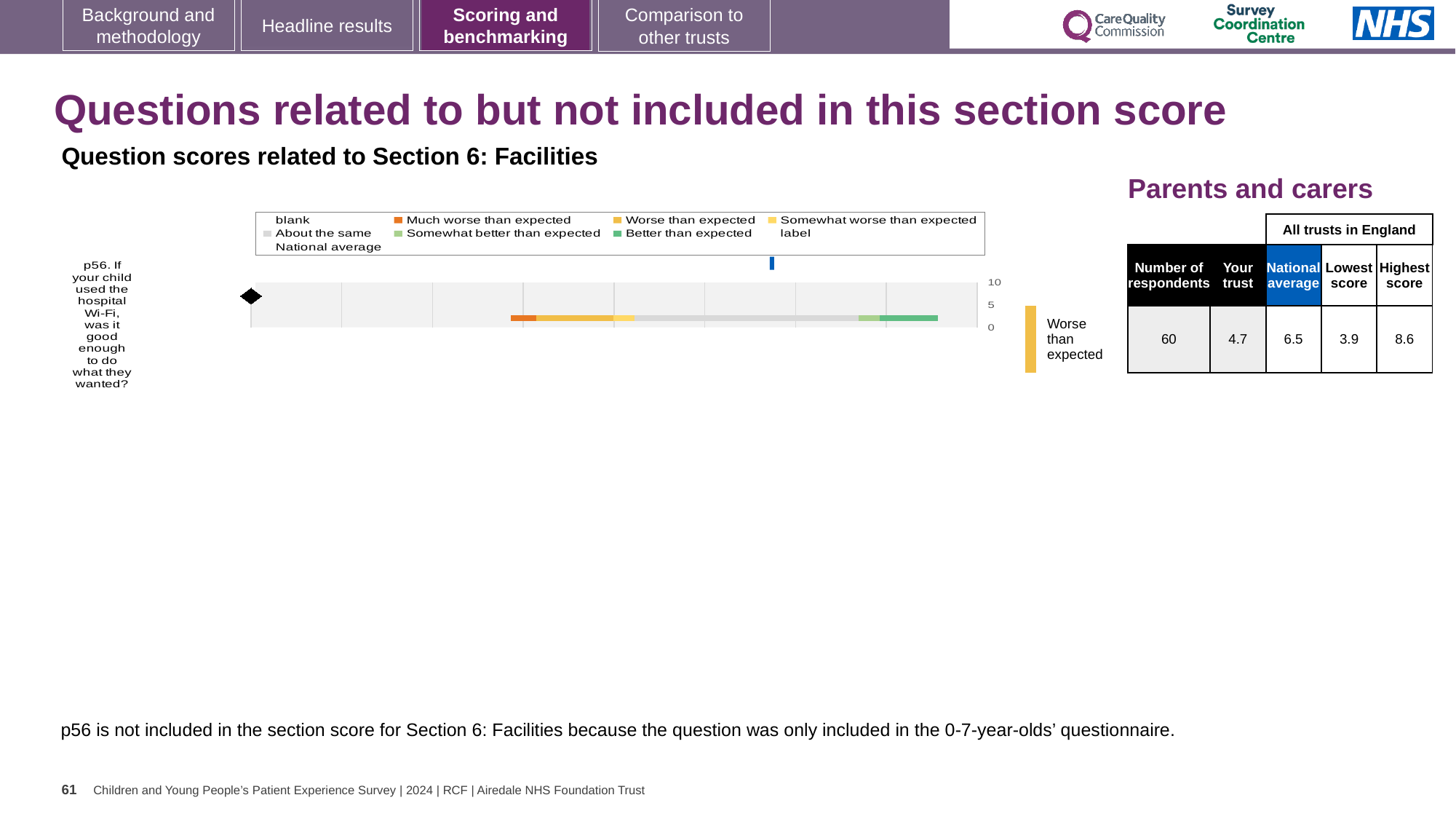
Which is larger for p56: the Your trust score or the National average? National average What is the difference between the Highest score and the Lowest score for p56? 4.7 What is the Highest score among all trusts in England for p56? 8.6 What is the National average score for p56 in the Parents and carers table? 6.5 What is the 'Your trust' score for p56 in the Parents and carers table? 4.7 How many questions (categories) are plotted on the chart? 1 What kind of chart is used to show the p56 question score? bar chart What is the Lowest score among all trusts in England for p56? 3.9 What benchmark label is shown to the right of the p56 chart? Worse than expected Which question is plotted on the chart? p56. If your child used the hospital Wi-Fi, was it good enough to do what they wanted? What is the difference between the National average and the Your trust score for p56? 1.8 How many respondents answered p56 in the Parents and carers table? 60